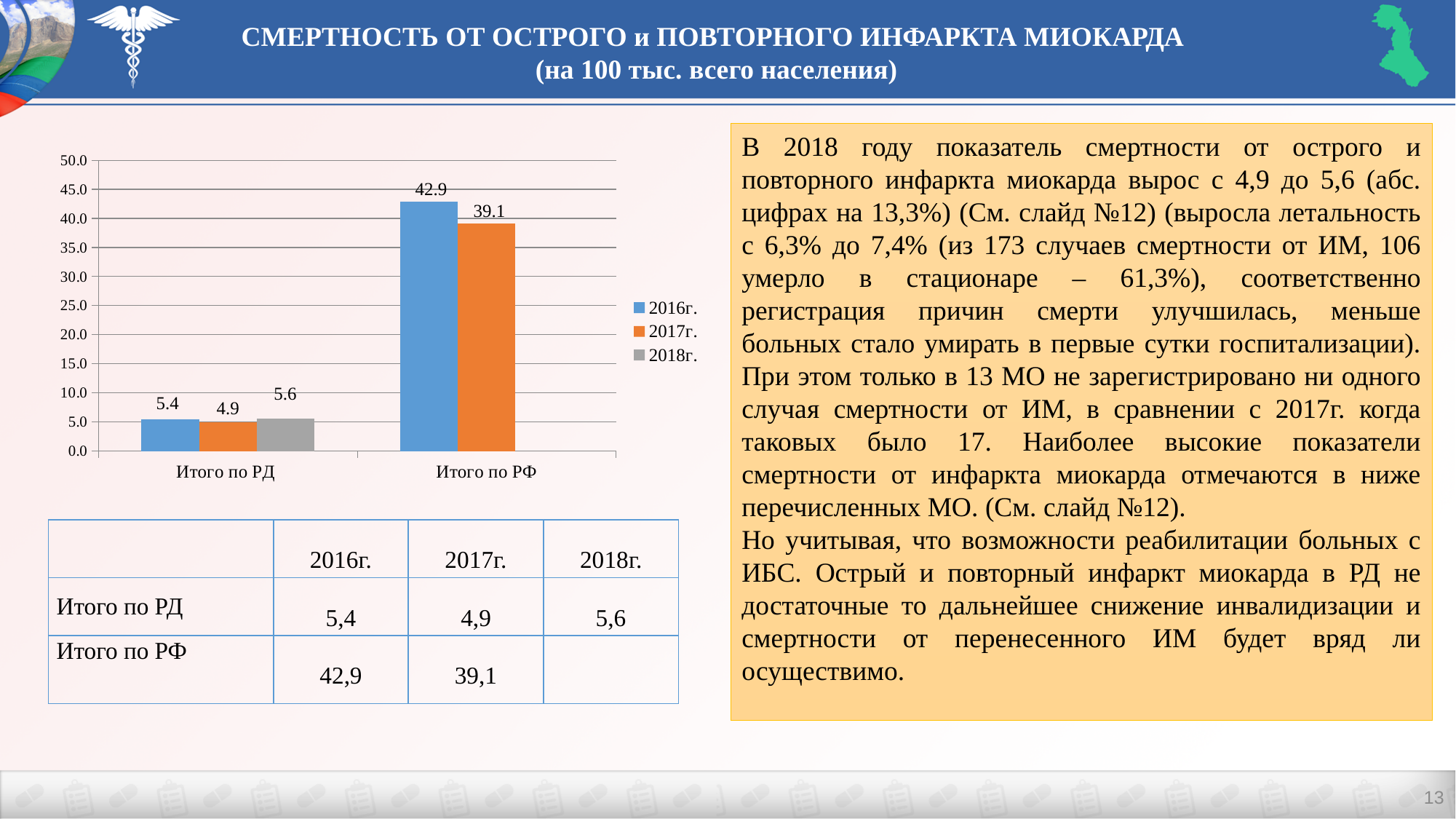
Is the 2017г. value for Итого по РФ greater or less than 35.0? greater Which year has the lowest value in the Итого по РД category? 2017г. What is the value for 2016г. in the Итого по РД category? 5.4 How many series does the legend list? 3 What is the difference between the 2016г. and 2017г. values for Итого по РФ? 3.8 What is the value for 2018г. in the Итого по РД category? 5.6 Which colour represents the 2018г. series in the chart? grey What kind of chart is shown on the slide? bar chart Which is larger: the 2016г. value for Итого по РД or the 2016г. value for Итого по РФ? Итого по РФ What is the difference between the 2018г. and 2017г. values for Итого по РД? 0.7 What is the value for 2017г. in the Итого по РФ category? 39.1 What is the value for 2016г. in the Итого по РФ category? 42.9